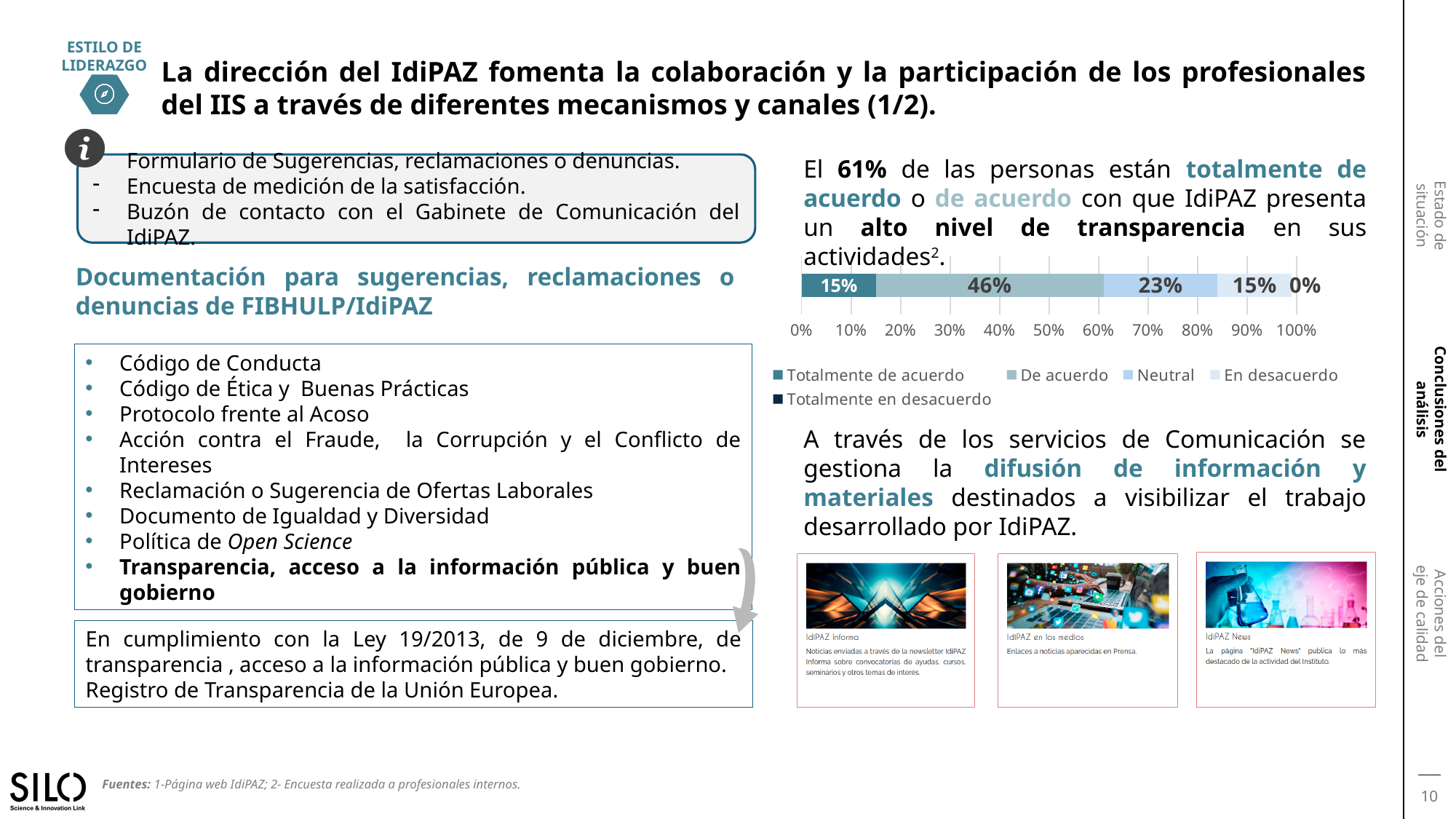
What percentage of respondents are 'En desacuerdo' in the chart? 15% What percentage of respondents are 'De acuerdo' in the chart? 46% Which is larger in the chart, the 'Neutral' share or the 'En desacuerdo' share? Neutral How many series does the chart legend list? 5 What percentage of respondents are 'Neutral' in the chart? 23% What is the difference between the 'De acuerdo' and 'Neutral' shares in the chart? 23% What type of chart is shown on the slide? Stacked bar chart What percentage of respondents are 'Totalmente en desacuerdo' in the chart? 0% What percentage of respondents are 'Totalmente de acuerdo' in the chart? 15% What is the combined share of 'Totalmente de acuerdo' and 'De acuerdo' in the chart? 61% Which response category has the smallest share in the chart? Totalmente en desacuerdo Which response category has the largest share in the chart? De acuerdo